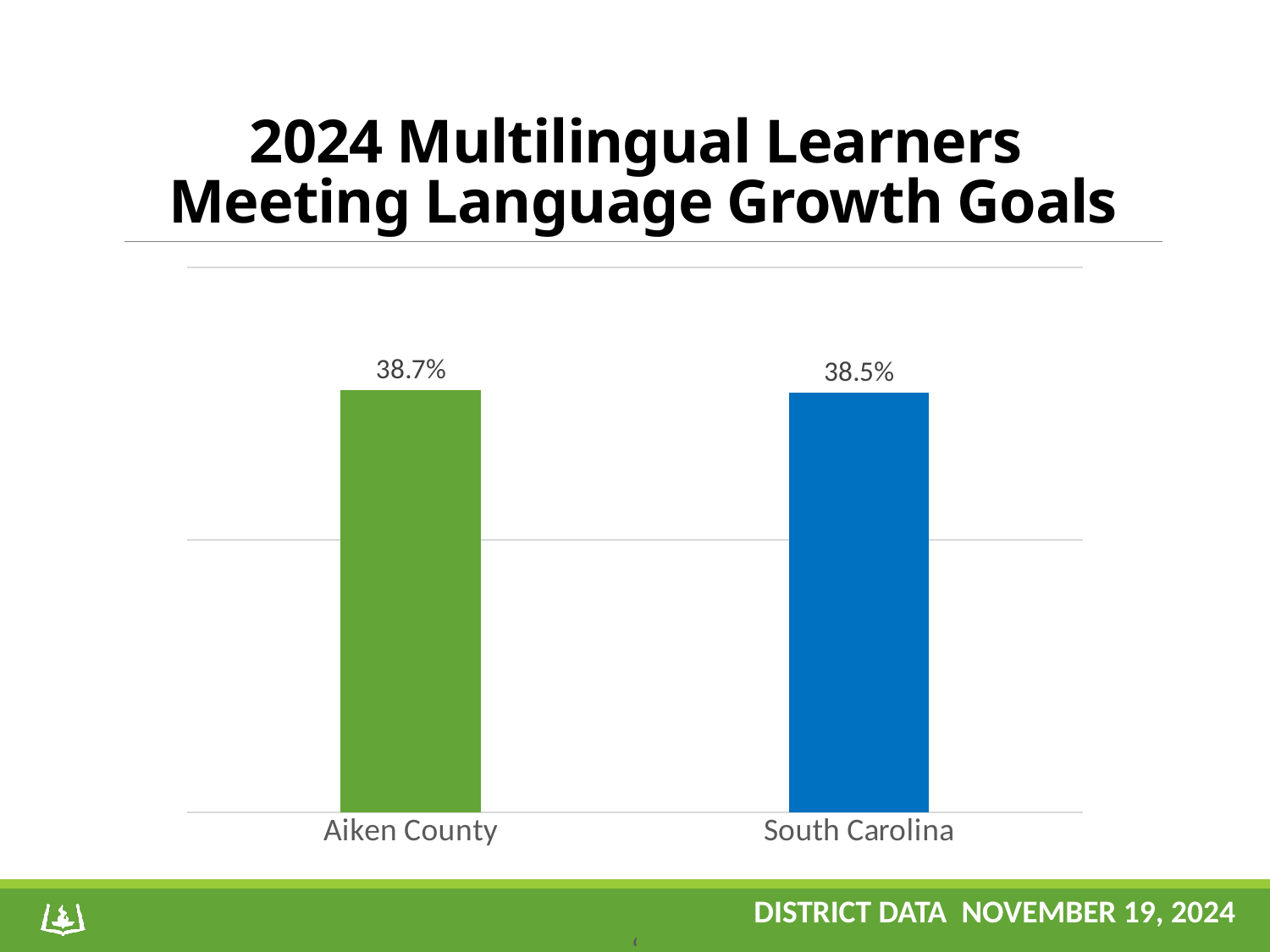
What is the title of the chart? 2024 Multilingual Learners Meeting Language Growth Goals What is the value for Aiken County? 38.7% Which category has the lowest value? South Carolina What kind of chart is shown on the slide? Bar chart Which category has the higher value, Aiken County or South Carolina? Aiken County Which category has the highest value? Aiken County What colour is the bar for South Carolina? Blue What is the difference between the values for Aiken County and South Carolina? 0.2% How many categories are shown in the chart? 2 What is the value for South Carolina? 38.5%